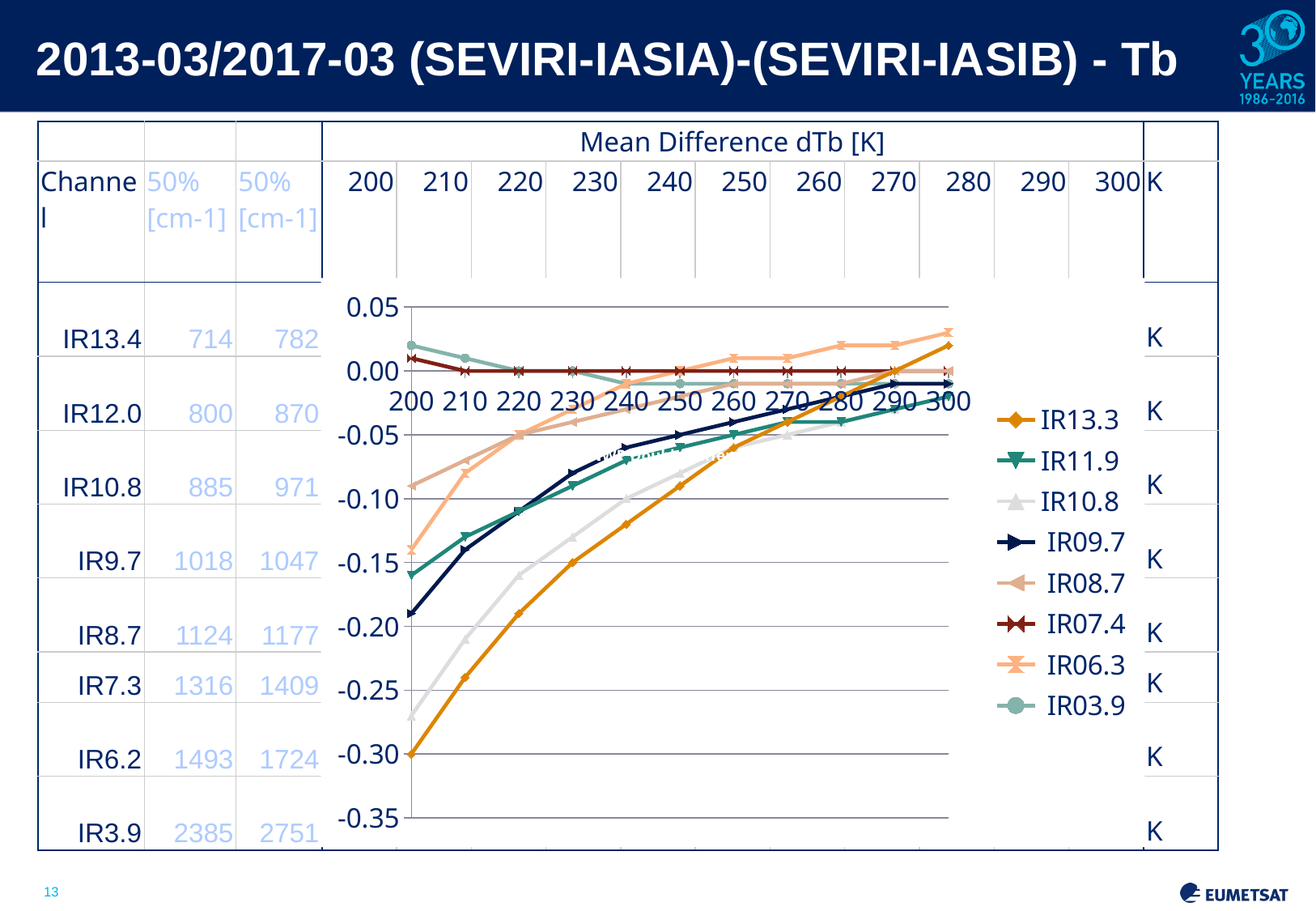
Which series is listed first in the chart legend? IR13.3 Is the value for IR09.7 at x = 200 greater or less than -0.15? less How many series does the chart legend list? 8 How many x-axis points (from 200 to 300) does the chart have? 11 At x = 200, which series has the larger value, IR11.9 or IR09.7? IR11.9 What kind of chart is shown on the slide? line chart Do the values for IR13.3 rise or fall as x increases from 200 to 300? rise Is the value for IR10.8 at x = 200 greater or less than -0.25? less What is the value for IR07.4 at x = 250? 0.00 Is the value for IR06.3 at x = 300 greater or less than 0.00? greater Which series has the lowest value at x = 200? IR13.3